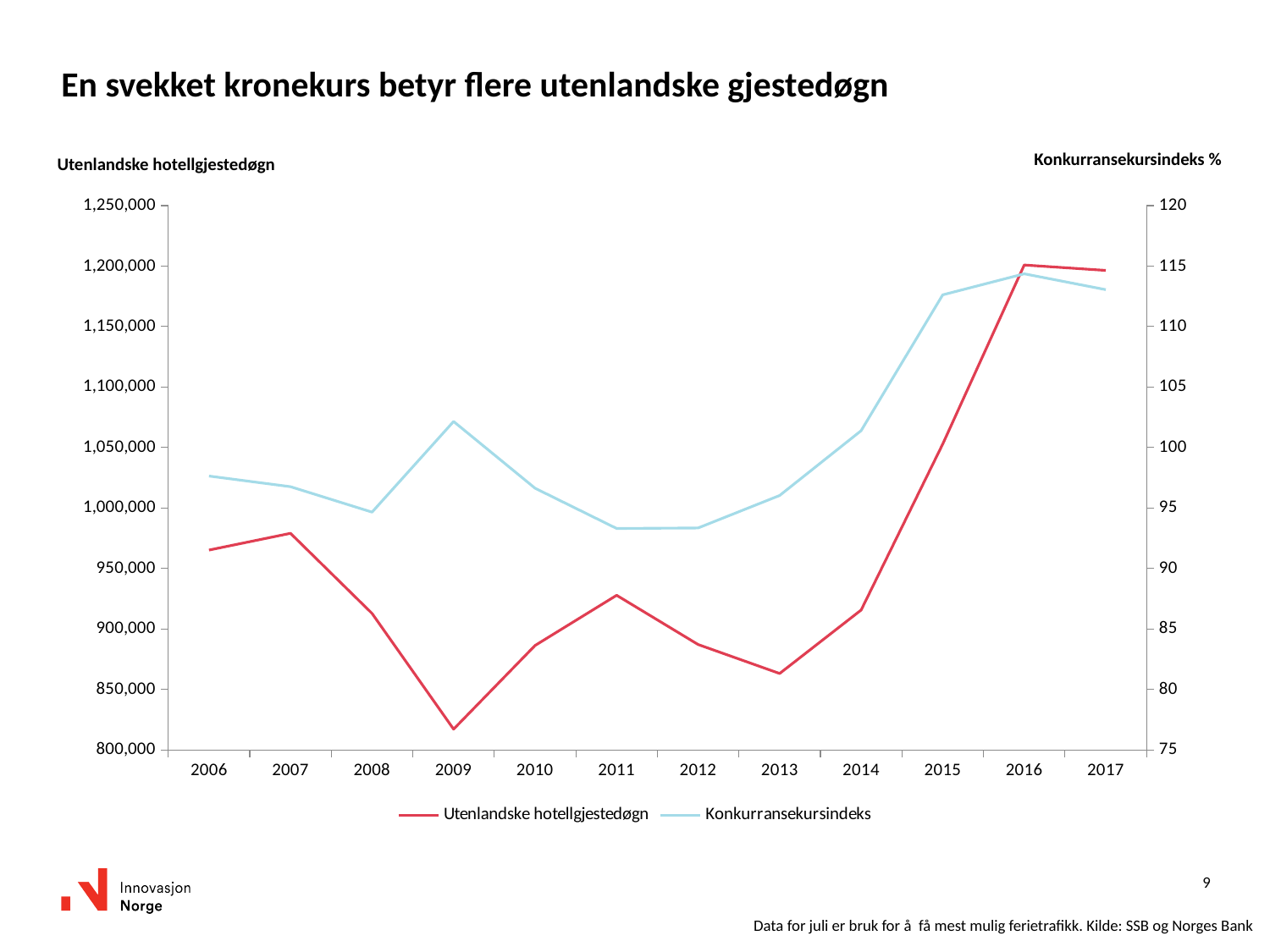
In which year is the Utenlandske hotellgjestedøgn line at its highest? 2016 Is the Konkurransekursindeks value in 2011 greater or less than 95? less In which year is the Utenlandske hotellgjestedøgn line at its lowest? 2009 How many years are plotted along the x axis? 12 In which year does the Konkurransekursindeks line reach its highest value? 2016 Does the Utenlandske hotellgjestedøgn line rise or fall from 2013 to 2016? rise Is the value of Utenlandske hotellgjestedøgn in 2009 greater or less than 850,000? less Is the Konkurransekursindeks value in 2015 greater or less than 110? greater What is the title of the slide? En svekket kronekurs betyr flere utenlandske gjestedøgn Which year has the higher Utenlandske hotellgjestedøgn value, 2007 or 2008? 2007 How many series does the legend list? 2 What kind of chart is shown on the slide? line chart